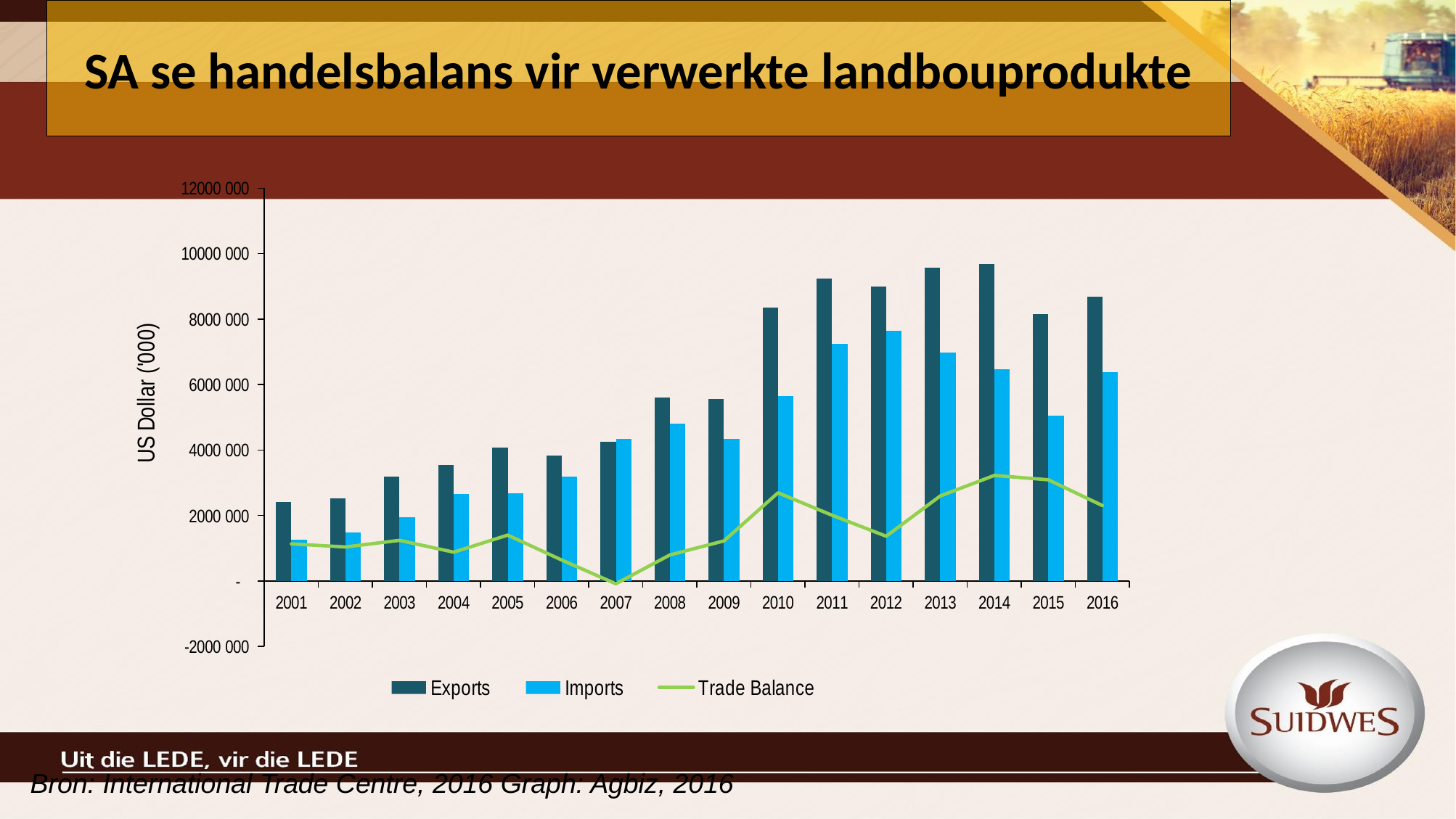
Is the Imports value for 2010 greater or less than 6000 000? less How many years are shown along the x axis of the chart? 16 Is the Trade Balance value for 2007 greater or less than 2000 000? less In which year is the Exports bar the lowest? 2001 How is the Trade Balance series drawn on the chart? as a line Is the Exports value for 2011 greater or less than 8000 000? greater What is the label on the vertical axis of the chart? US Dollar ('000) In which year is the Imports bar the highest? 2012 How many series does the chart legend list? 3 What kind of chart is used to show the Exports and Imports series? bar chart Do the Exports bars generally rise or fall from 2001 to 2011? rise In 2012, which is larger: Exports or Imports? Exports